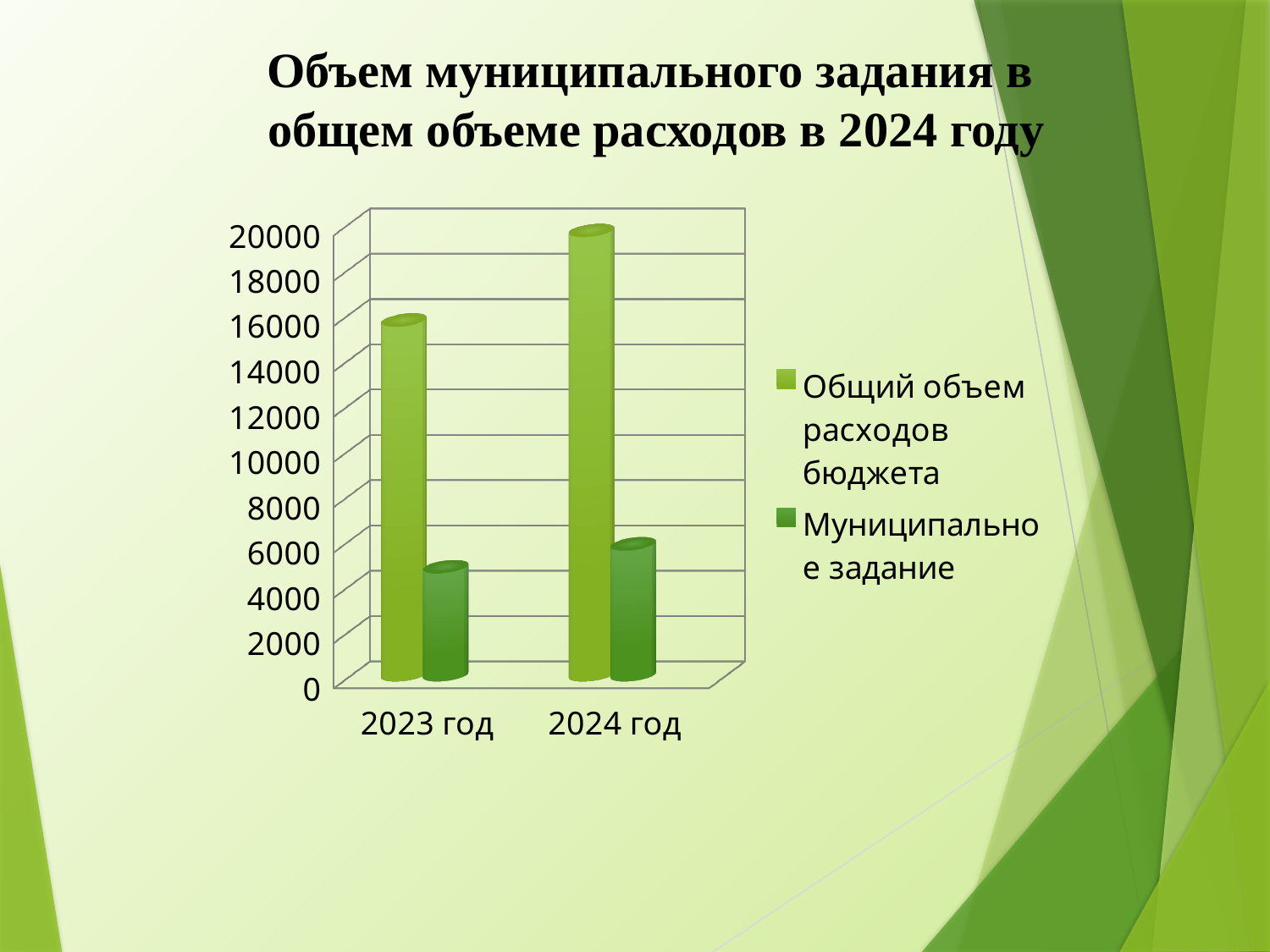
How many series does the legend list? 2 How many categories are shown on the x axis? 2 What kind of chart is shown on the slide? bar chart Is the value for Муниципальное задание in 2024 год greater or less than 4000? greater What is the title of the chart on the slide? Объем муниципального задания в общем объеме расходов в 2024 году Does the value for Общий объем расходов бюджета rise or fall from 2023 год to 2024 год? rise Is the value for Муниципальное задание in 2023 год greater or less than 8000? less Is the value for Общий объем расходов бюджета in 2024 год greater or less than 18000? greater Which bar is the tallest in the chart? Общий объем расходов бюджета in 2024 год Which series does the darker green bar represent? Муниципальное задание Which year has the larger value for Общий объем расходов бюджета, 2023 год or 2024 год? 2024 год